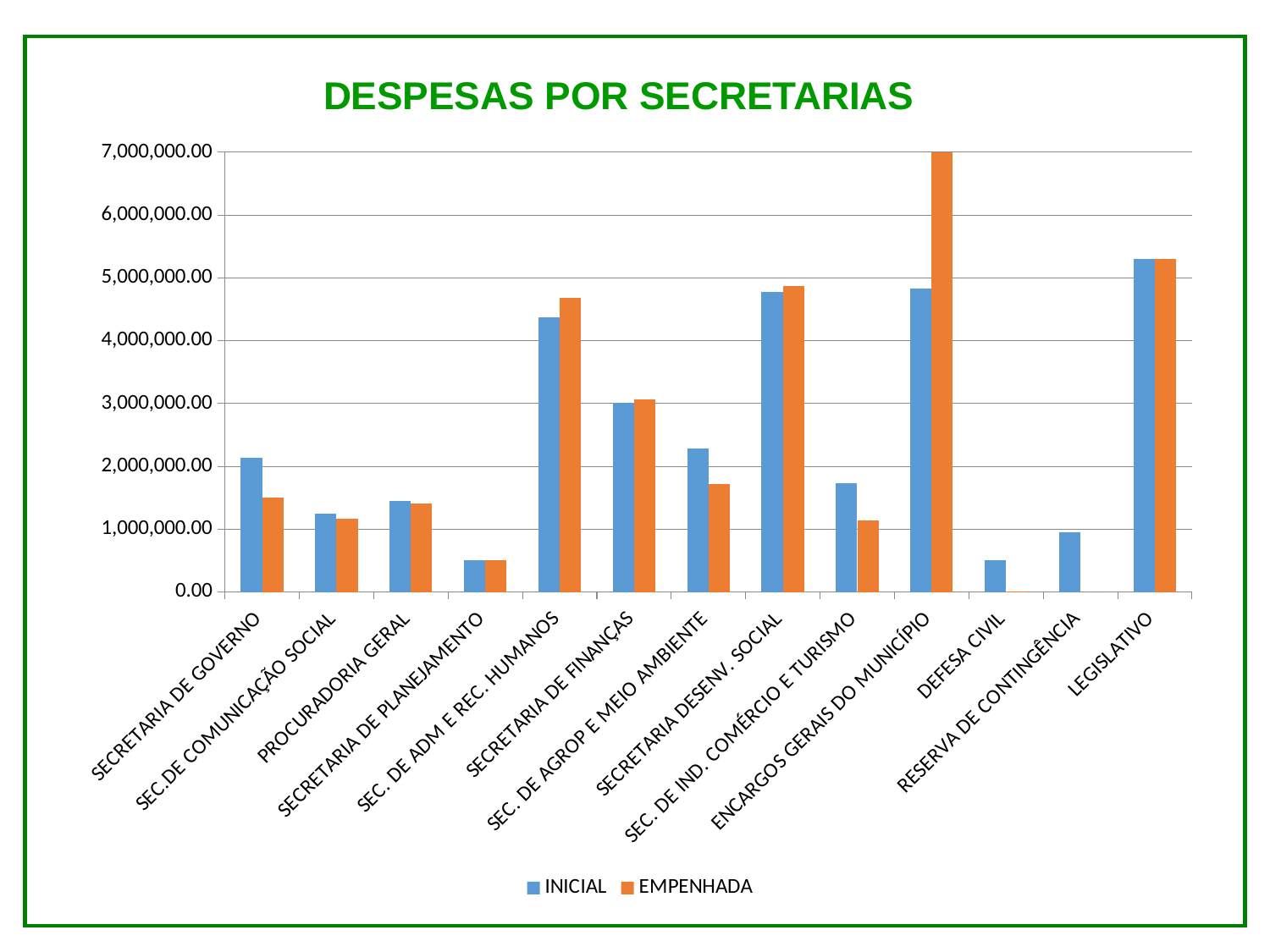
Is the EMPENHADA value for SEC. DE ADM E REC. HUMANOS greater or less than 4,000,000.00? greater Which colour represents the EMPENHADA series in the legend? Orange Which category has the highest EMPENHADA value? ENCARGOS GERAIS DO MUNICÍPIO For SECRETARIA DE GOVERNO, which is larger: INICIAL or EMPENHADA? INICIAL For SEC. DE ADM E REC. HUMANOS, which is larger: INICIAL or EMPENHADA? EMPENHADA How many categories are shown on the x axis? 13 What is the title of the chart? DESPESAS POR SECRETARIAS Which category has the highest INICIAL value? LEGISLATIVO What type of chart is shown on the slide? Bar chart How many series does the legend list? 2 Is the INICIAL value for DEFESA CIVIL greater or less than 1,000,000.00? less Is the EMPENHADA value for ENCARGOS GERAIS DO MUNICÍPIO greater or less than 6,000,000.00? greater